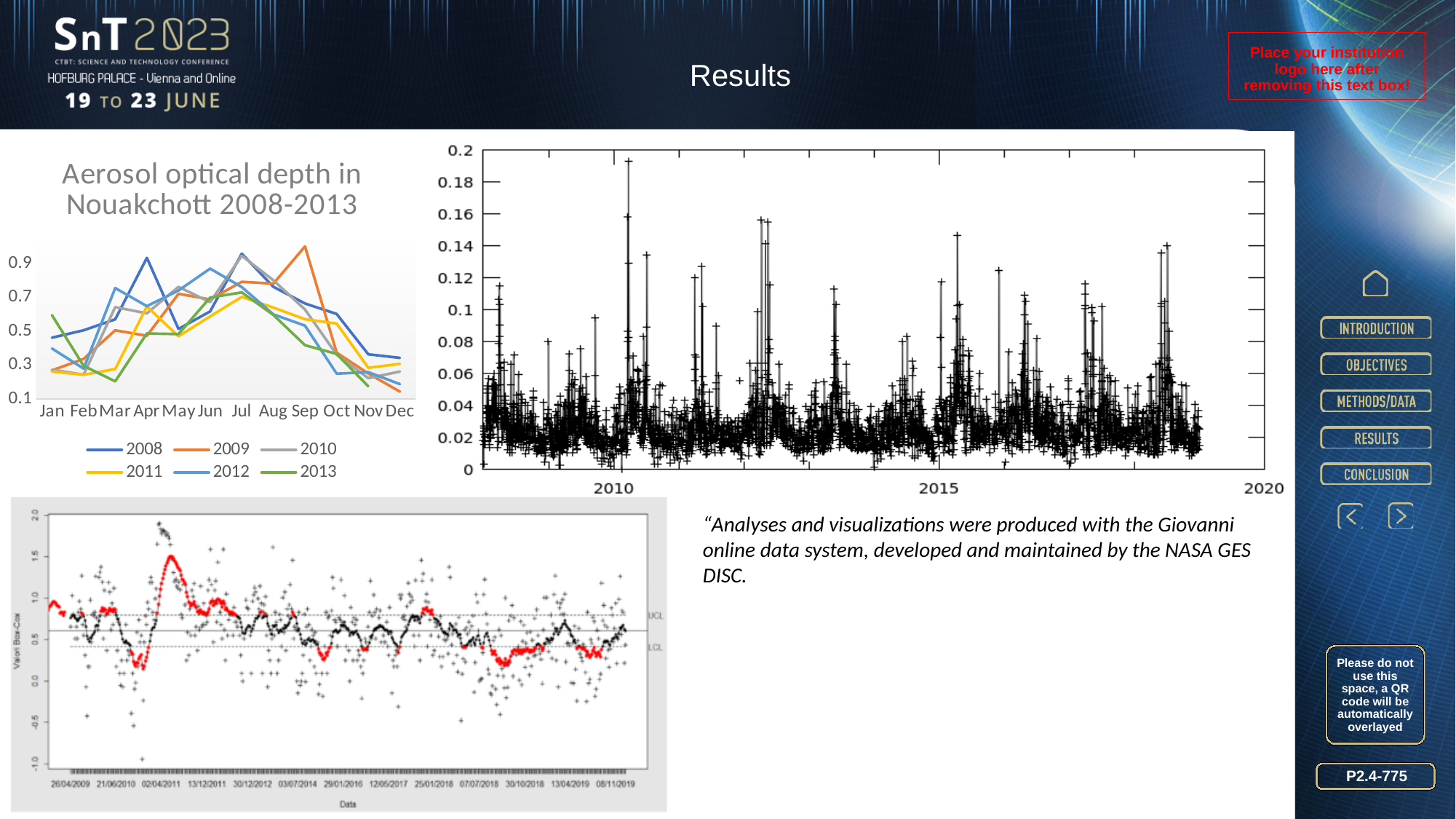
In the top-right time series chart, is the highest plotted value greater or less than 0.18? greater In the 'Aerosol optical depth in Nouakchott 2008-2013' chart, which is larger in Apr: the 2008 value or the 2011 value? 2008 What is the y-axis label of the bottom-left chart? Valor Box-Cox What kind of chart is the 'Aerosol optical depth in Nouakchott 2008-2013' chart? line chart In the 'Aerosol optical depth in Nouakchott 2008-2013' chart, in which month does the 2008 series reach its highest value? Jul How many months are shown on the x axis of the 'Aerosol optical depth in Nouakchott 2008-2013' chart? 12 How many series does the legend of the 'Aerosol optical depth in Nouakchott 2008-2013' chart list? 6 In the 'Aerosol optical depth in Nouakchott 2008-2013' chart, is the value for 2009 in Sep greater or less than 0.7? greater In the 'Aerosol optical depth in Nouakchott 2008-2013' chart, in which month does the 2009 series reach its highest value? Sep In the 'Aerosol optical depth in Nouakchott 2008-2013' chart, is the value for 2013 in Mar greater or less than 0.3? less In the 'Aerosol optical depth in Nouakchott 2008-2013' chart, does the 2009 series rise or fall from Sep to Dec? fall In the 'Aerosol optical depth in Nouakchott 2008-2013' chart, which is larger in Sep: the 2009 value or the 2013 value? 2009